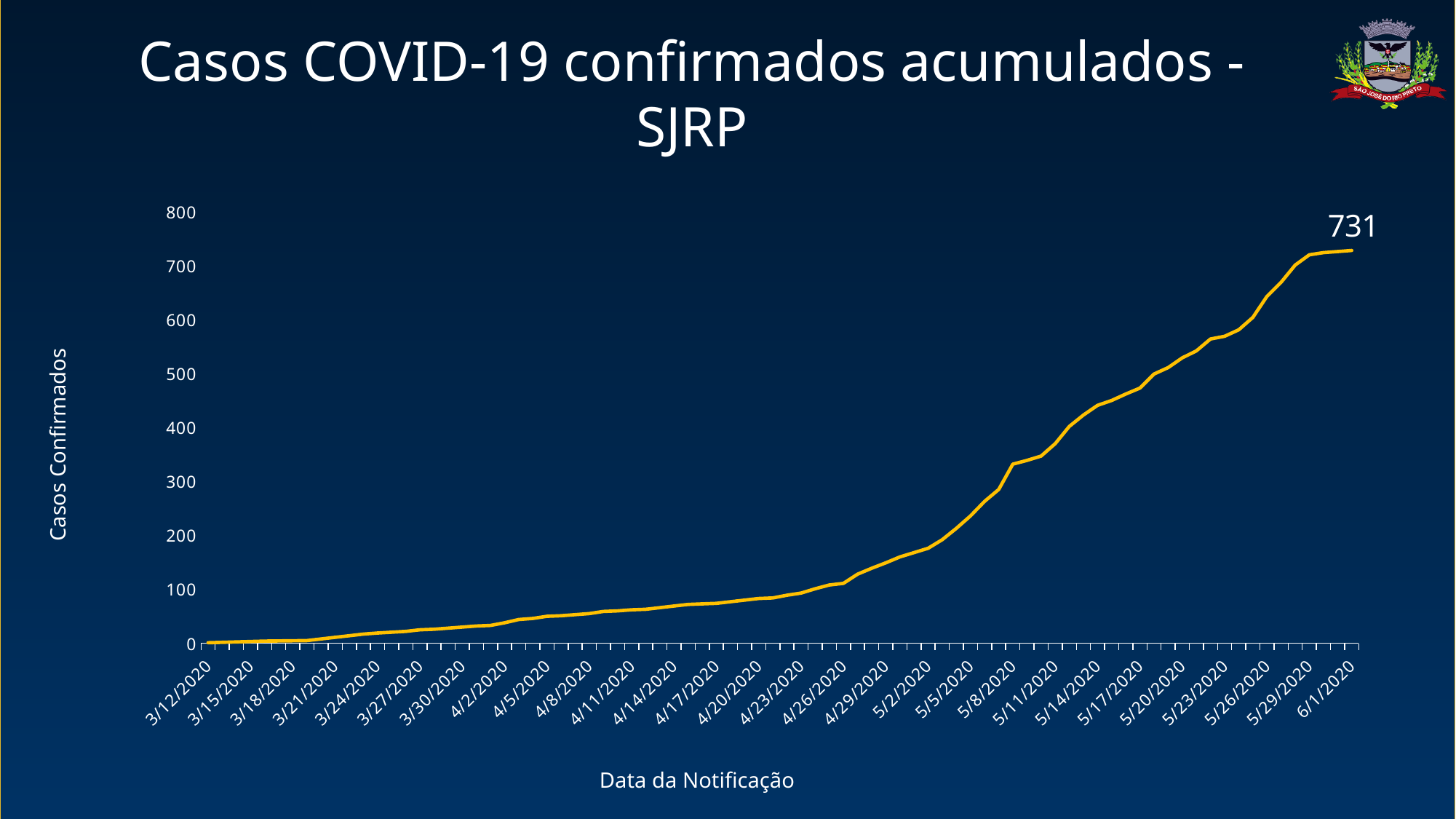
What is the title of the chart? Casos COVID-19 confirmados acumulados - SJRP What is the value of the last data point on the chart, labelled at 6/1/2020? 731 What kind of chart is shown on the slide? line chart Is the value for 5/20/2020 greater or less than 500? greater What is the label of the x axis? Data da Notificação On which date does the chart reach its highest value? 6/1/2020 Which date has the larger value, 4/26/2020 or 5/14/2020? 5/14/2020 Do the values rise or fall along the x axis from 3/12/2020 to 6/1/2020? rise Is the value for 4/14/2020 greater or less than 100? less On which date is the chart's value lowest? 3/12/2020 Is the value for 5/8/2020 greater or less than 300? greater